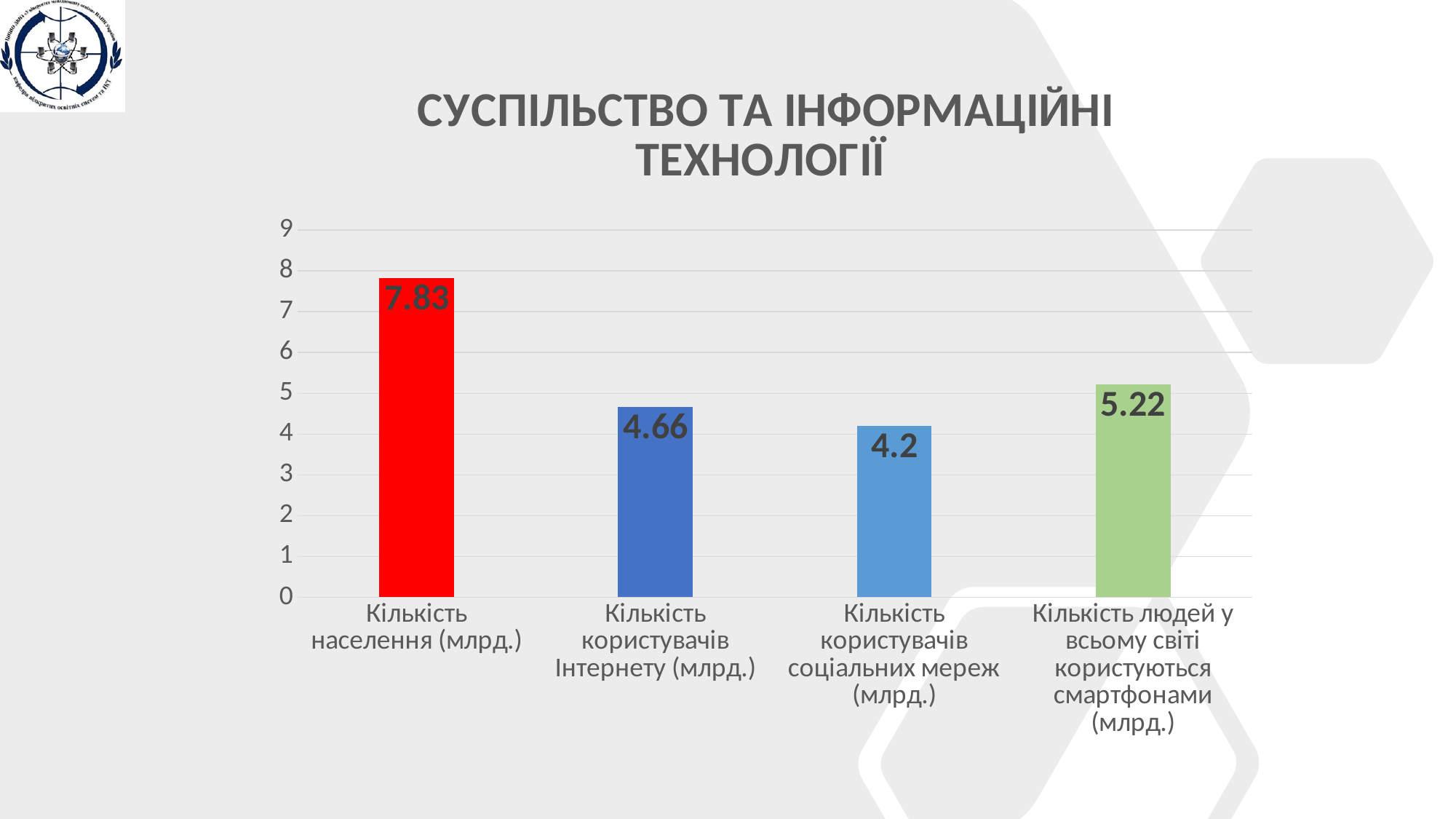
How many categories are shown in the chart? 4 Which category has the highest value? Кількість населення (млрд.) What is the title of the slide? СУСПІЛЬСТВО ТА ІНФОРМАЦІЙНІ ТЕХНОЛОГІЇ What is the value for Кількість користувачів соціальних мереж (млрд.)? 4.2 Which category has the lowest value? Кількість користувачів соціальних мереж (млрд.) Which is larger: the value for Кількість користувачів Інтернету (млрд.) or the value for Кількість людей у всьому світі користуються смартфонами (млрд.)? Кількість людей у всьому світі користуються смартфонами (млрд.) What is the value for Кількість населення (млрд.)? 7.83 What is the value for Кількість користувачів Інтернету (млрд.)? 4.66 What kind of chart is shown on the slide? Bar chart What is the difference between the value for Кількість населення (млрд.) and the value for Кількість користувачів Інтернету (млрд.)? 3.17 What is the difference between the value for Кількість людей у всьому світі користуються смартфонами (млрд.) and the value for Кількість користувачів соціальних мереж (млрд.)? 1.02 What is the value for Кількість людей у всьому світі користуються смартфонами (млрд.)? 5.22